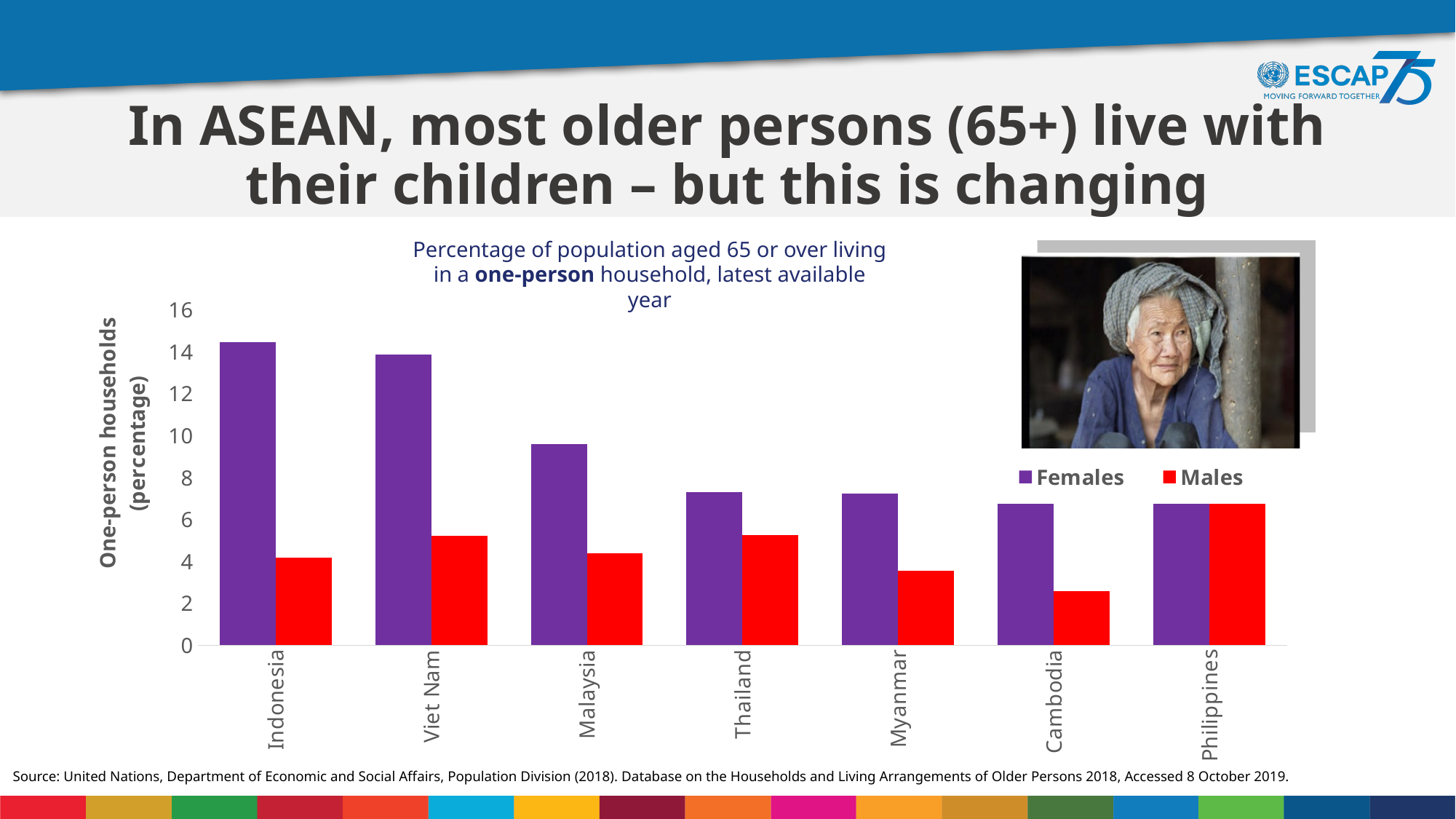
How many series does the chart's legend list? 2 Which country has the highest value for Males? Philippines Is the Females value for Indonesia greater or less than 14? greater Which country has the highest value for Females? Indonesia How many countries are shown on the x axis of the chart? 7 Which is larger, the Males value for Thailand or the Males value for Myanmar? Thailand Is the Females value for Malaysia greater or less than 10? less Is the Males value for Cambodia greater or less than 4? less Which colour represents Males in the chart? red What kind of chart is shown on the slide? bar chart Do the Females values generally rise or fall moving from Indonesia to Philippines along the x axis? fall Which country has the lowest value for Males? Cambodia